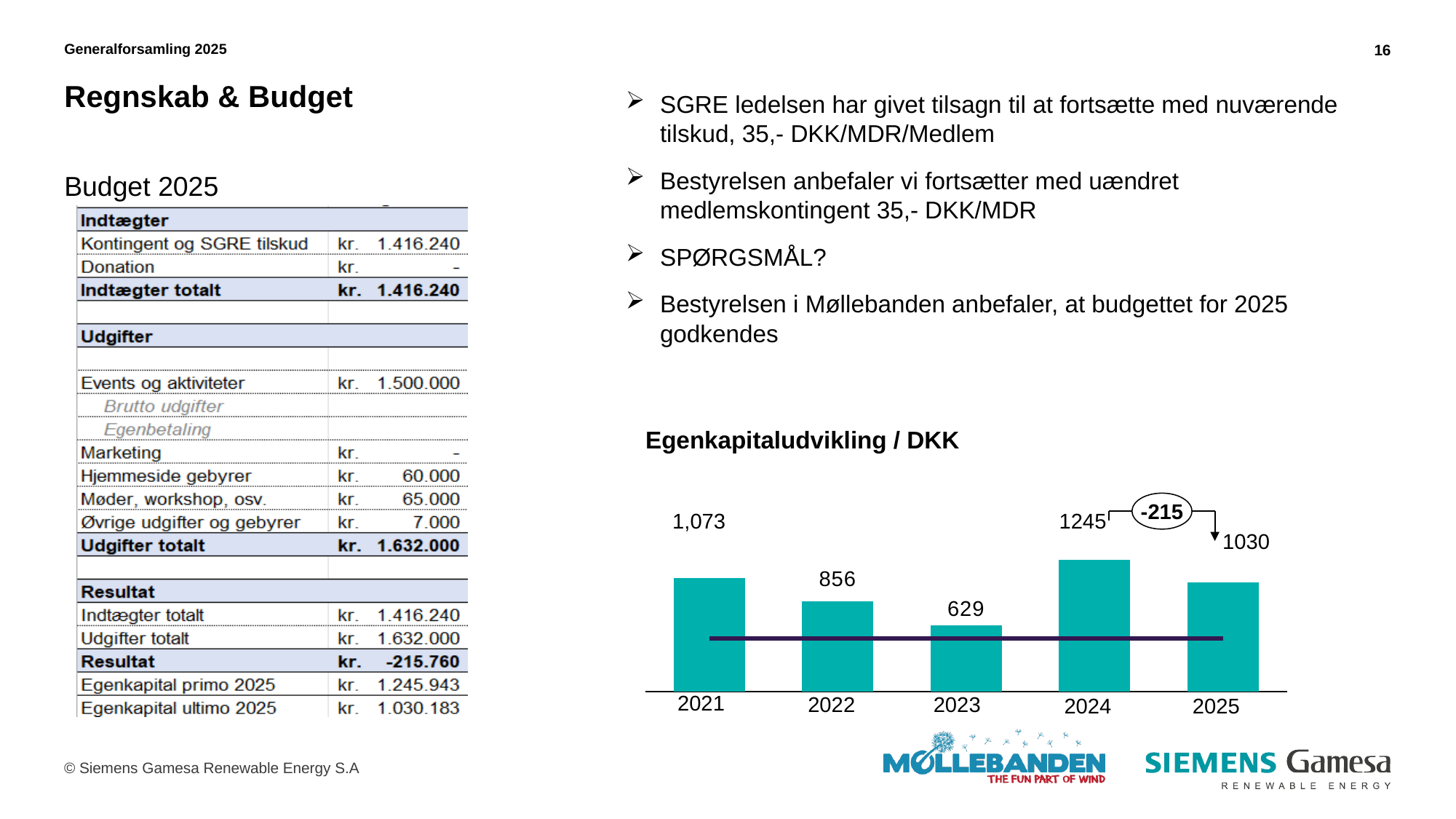
How many years are shown on the x axis of the Egenkapitaludvikling / DKK chart? 5 In the Egenkapitaludvikling / DKK chart, which year has the lowest value? 2023 In the Egenkapitaludvikling / DKK chart, what is the value for 2023? 629 In the Egenkapitaludvikling / DKK chart, what is the value for 2025? 1030 What kind of chart is the Egenkapitaludvikling / DKK chart? combination bar and line chart In the Egenkapitaludvikling / DKK chart, which is larger, the value for 2022 or the value for 2023? 2022 In the Egenkapitaludvikling / DKK chart, what is the value for 2021? 1,073 In the Egenkapitaludvikling / DKK chart, which year has the highest value? 2024 What is the title of the chart on the slide? Egenkapitaludvikling / DKK In the Egenkapitaludvikling / DKK chart, what is the difference between the values for 2024 and 2025? 215 In the Egenkapitaludvikling / DKK chart, what change is shown in the annotation between 2024 and 2025? -215 In the Egenkapitaludvikling / DKK chart, what is the value for 2024? 1245